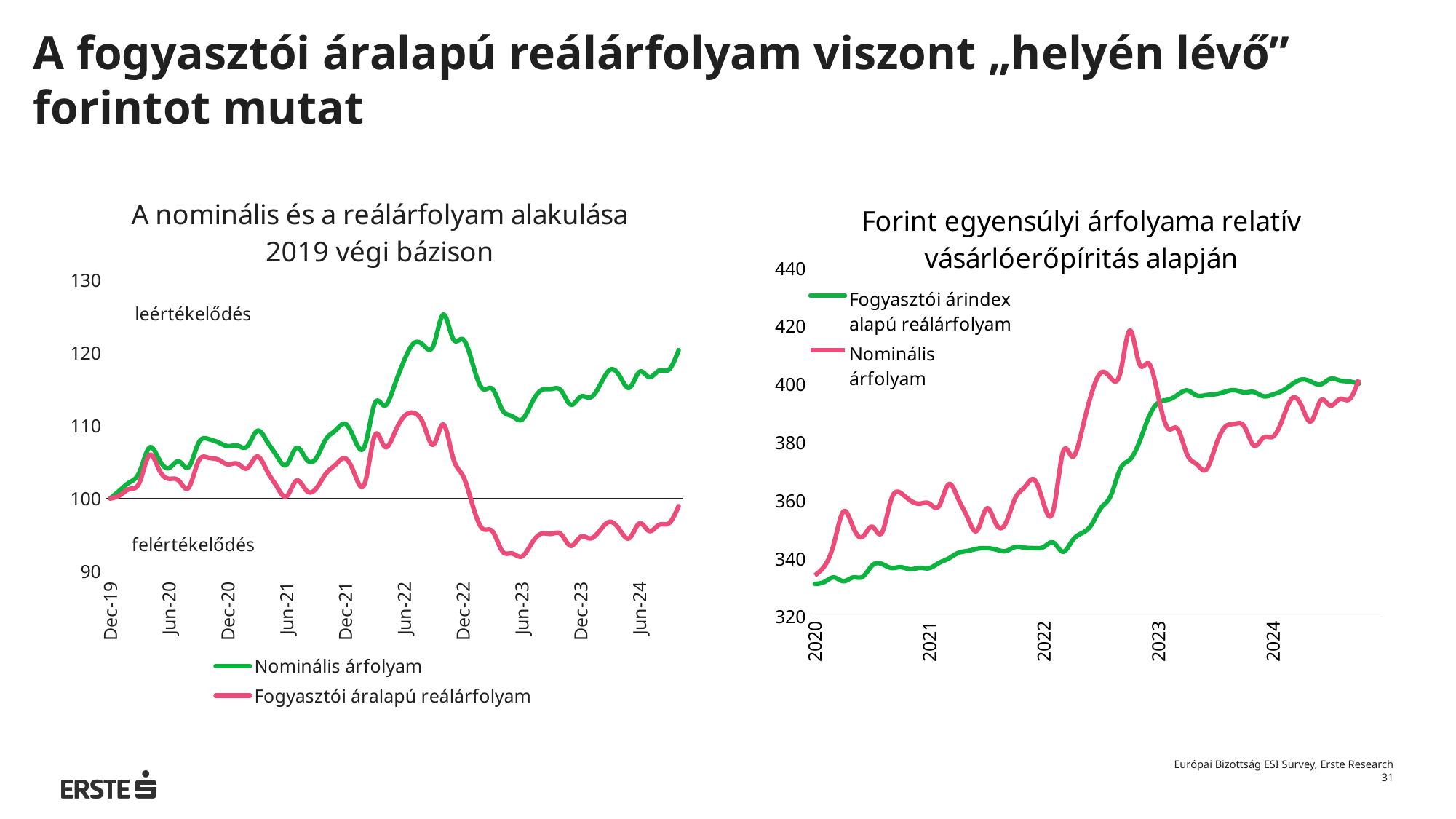
In the right chart, is the peak value of Nominális árfolyam greater or less than 400? greater In the right chart, is the value of Fogyasztói árindex alapú reálárfolyam at the start of 2020 greater or less than 340? less In the left chart, is the value of Fogyasztói áralapú reálárfolyam at Jun-23 greater or less than 100? less In the right chart, does the Fogyasztói árindex alapú reálárfolyam series rise or fall overall from 2020 to 2024? rise What kind of chart is the right chart, 'Forint egyensúlyi árfolyama relatív vásárlóerőpíritás alapján'? line chart What kind of chart is the left chart, 'A nominális és a reálárfolyam alakulása 2019 végi bázison'? line chart In the left chart, which series is drawn in green? Nominális árfolyam How many series does the legend of the left chart list? 2 In the right chart, which series is drawn in pink? Nominális árfolyam How many series does the legend of the right chart list? 2